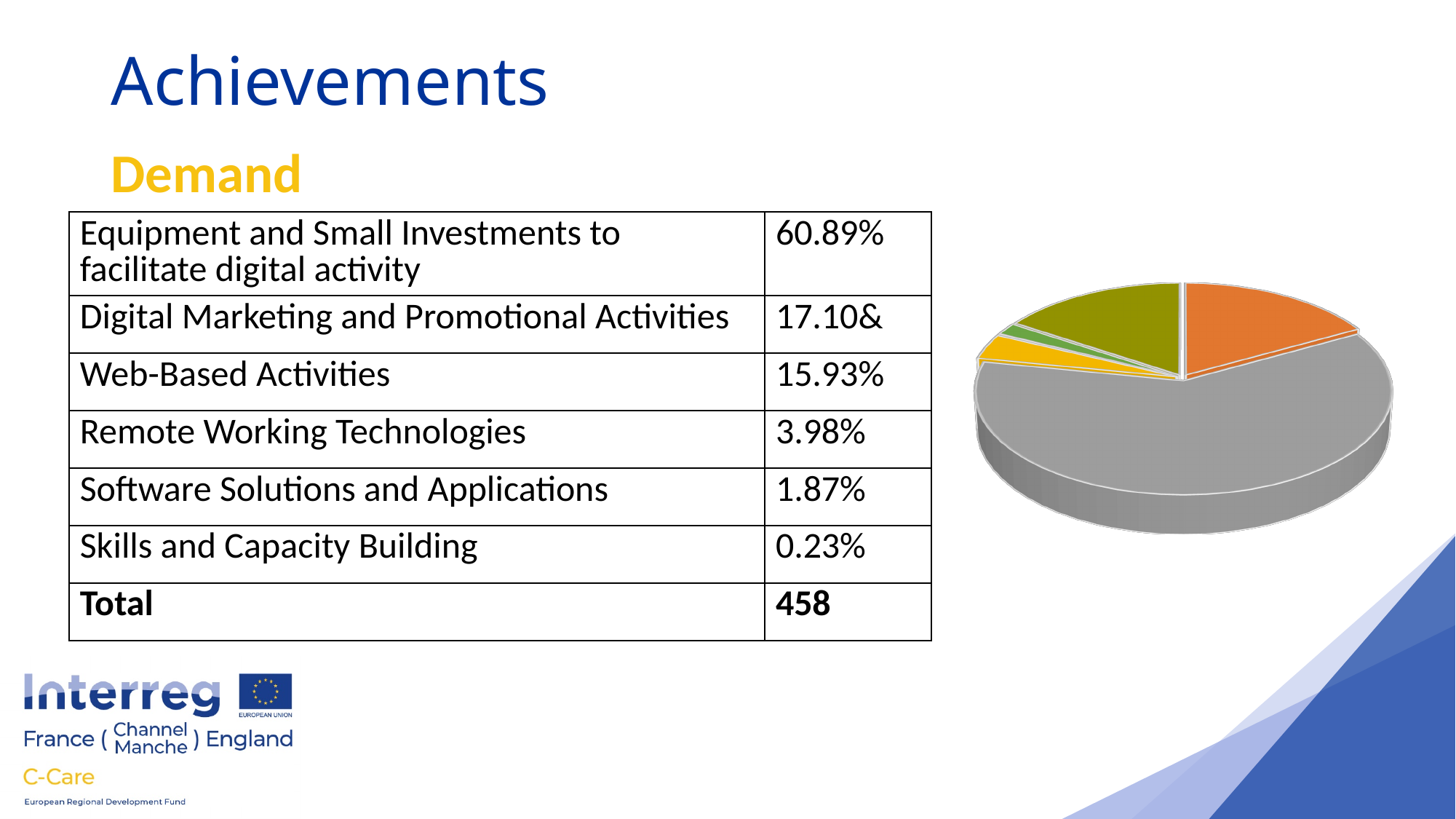
According to the Demand table, which is larger: Software Solutions and Applications or Remote Working Technologies? Remote Working Technologies According to the Demand table, which category has the lowest value? Skills and Capacity Building How many slices does the pie chart have? 6 According to the Demand table, what is the value for Web-Based Activities? 15.93% Does the pie chart have a legend? No Which colour slice is the largest in the pie chart? gray According to the Demand table, which category has the highest value? Equipment and Small Investments to facilitate digital activity What kind of chart is shown on the right of the slide? pie chart According to the Demand table, what is the value for Equipment and Small Investments to facilitate digital activity? 60.89% According to the Demand table, what is the Total? 458 Is the gray slice of the pie chart larger or smaller than half of the pie? larger According to the Demand table, what is the value for Remote Working Technologies? 3.98%